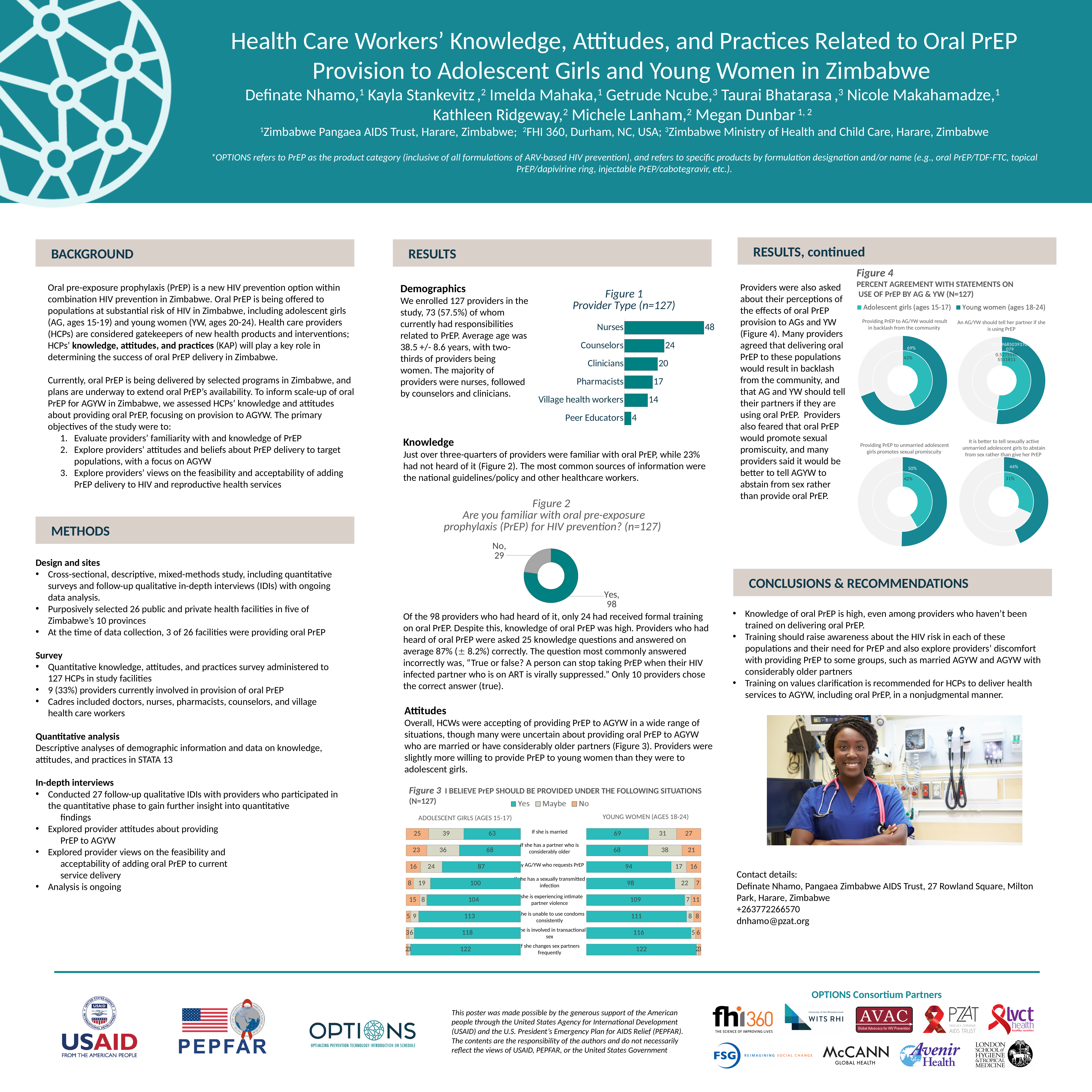
In Figure 2, how many providers answered Yes to being familiar with oral PrEP? 98 In Figure 1 (Provider Type), which is larger: Pharmacists or Village health workers? Pharmacists In Figure 1 (Provider Type), how many provider types are shown? 6 In Figure 1 (Provider Type), what is the difference between the number of Counselors and the number of Clinicians? 4 In Figure 1 (Provider Type), how many providers were nurses? 48 In Figure 2, how many providers answered No? 29 In Figure 1 (Provider Type), which provider type has the highest count? Nurses What kind of chart is Figure 1 (Provider Type)? Bar chart In Figure 4, what percentage of providers agreed that providing PrEP to unmarried adolescent girls promotes sexual promiscuity, for young women (ages 18-24)? 50% In Figure 3, how many series does the legend list? 3 In Figure 3, for young women (ages 18-24), how many providers said Yes to providing PrEP if she is married? 69 In Figure 1 (Provider Type), which provider type has the lowest count? Peer Educators